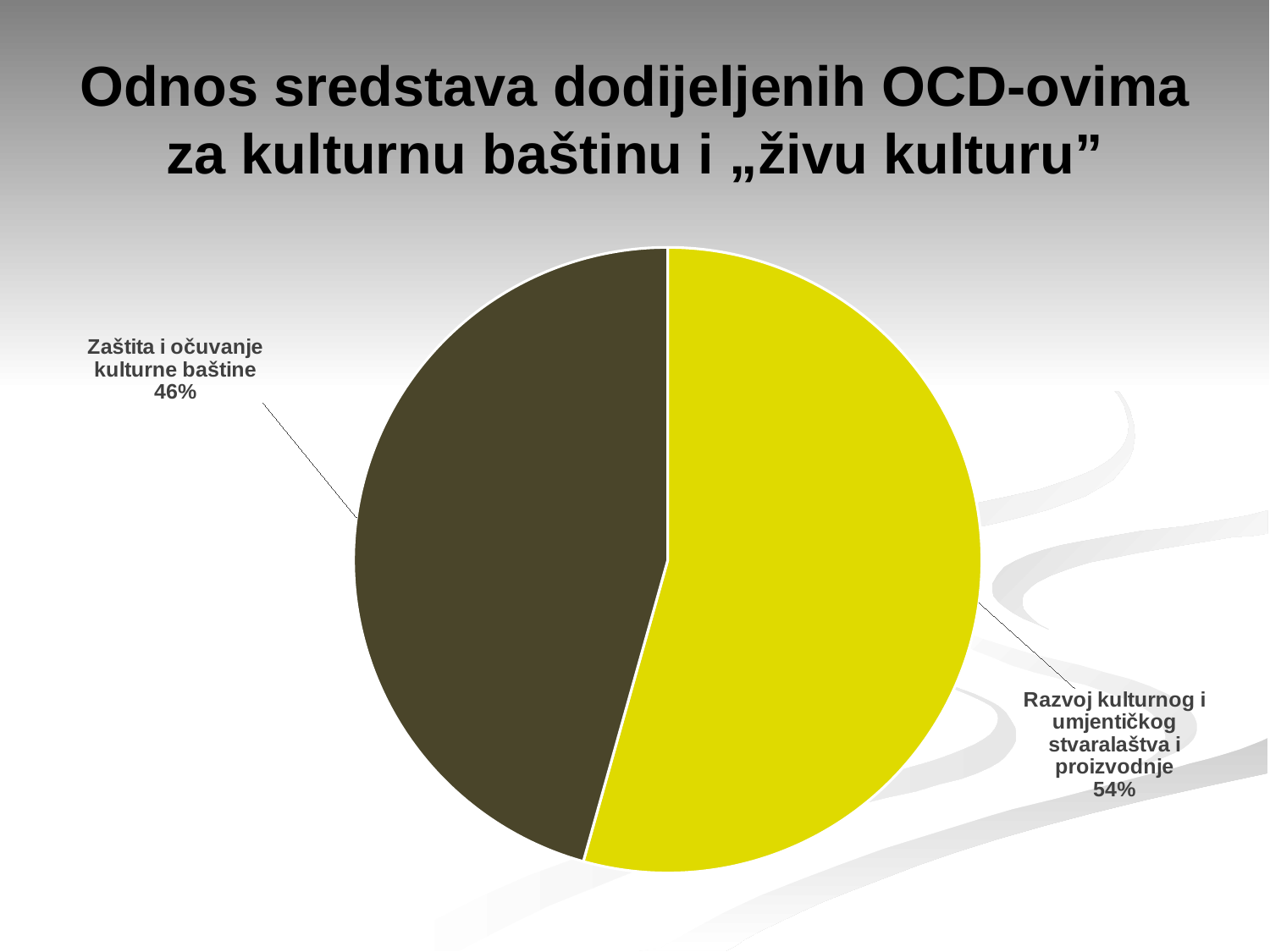
What share of the pie does "Razvoj kulturnog i umjentičkog stvaralaštva i proizvodnje" have? 54% Which slice is the smallest? Zaštita i očuvanje kulturne baštine Is the share for "Zaštita i očuvanje kulturne baštine" greater or less than 50%? less How many slices does the pie chart have? 2 What is the title of the slide? Odnos sredstava dodijeljenih OCD-ovima za kulturnu baštinu i „živu kulturu” What is the difference in percentage points between the two slices? 8 What share of the pie does "Zaštita i očuvanje kulturne baštine" have? 46% What kind of chart is shown on the slide? pie chart Which is larger: the share for "Zaštita i očuvanje kulturne baštine" or for "Razvoj kulturnog i umjentičkog stvaralaštva i proizvodnje"? Razvoj kulturnog i umjentičkog stvaralaštva i proizvodnje Which slice is the largest? Razvoj kulturnog i umjentičkog stvaralaštva i proizvodnje What colour is the slice for "Razvoj kulturnog i umjentičkog stvaralaštva i proizvodnje"? yellow